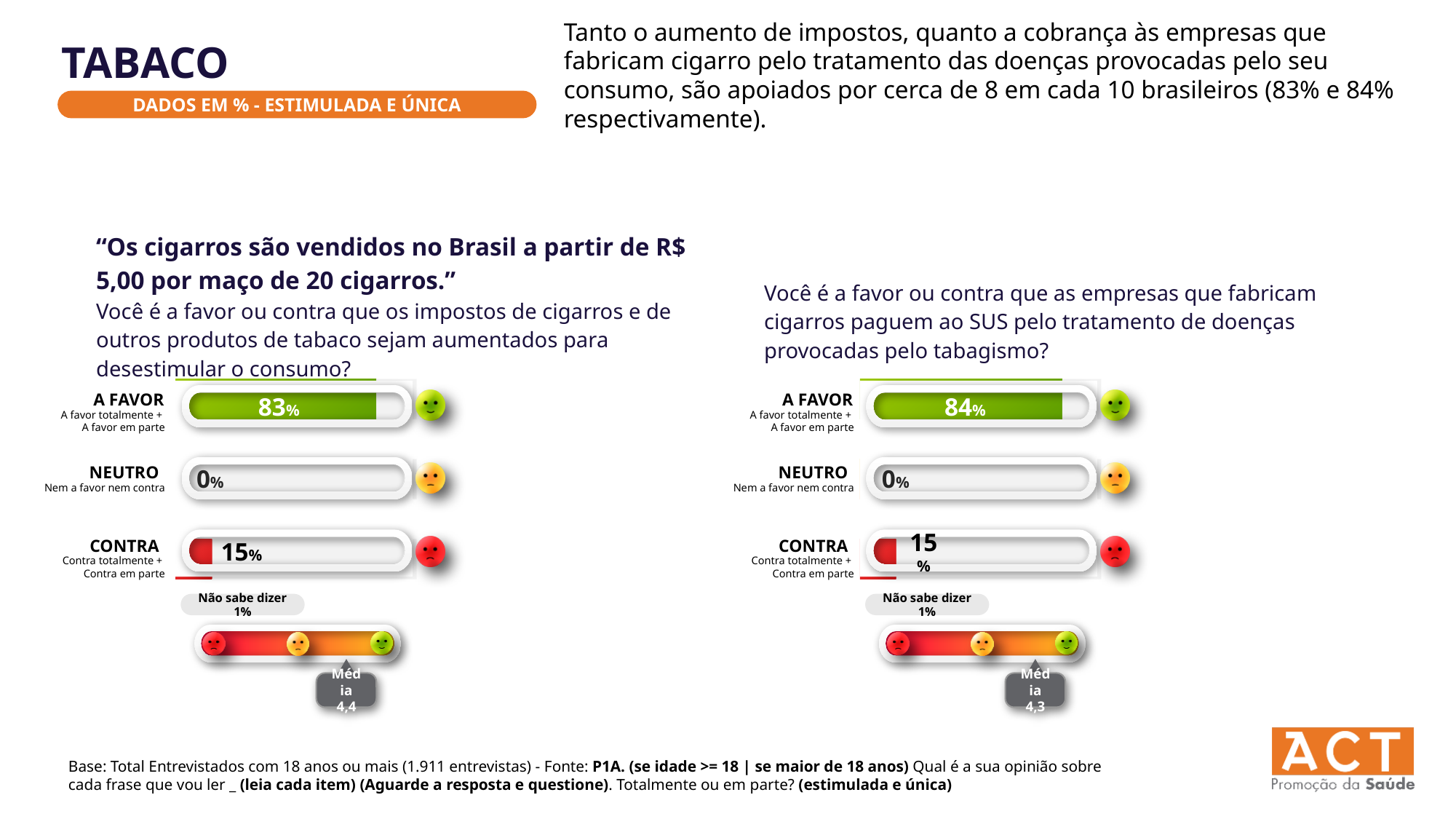
In the left chart about increasing cigarette taxes, which category has the highest value? A FAVOR In the right chart about companies paying the SUS, what percentage is shown for NEUTRO? 0% What percentage is shown for 'Não sabe dizer' in the right chart about companies paying the SUS? 1% In the left chart about increasing cigarette taxes, what is the difference between A FAVOR and CONTRA? 68 percentage points In the left chart about increasing cigarette taxes, what percentage is shown for CONTRA? 15% In the right chart about companies paying the SUS, what is the difference between A FAVOR and CONTRA? 69 percentage points In the right chart about companies paying the SUS, which category has the lowest value? NEUTRO In the left chart about increasing cigarette taxes, what percentage is shown for A FAVOR? 83% How many response categories are shown as bars in the left chart about increasing cigarette taxes? 3 What is the Média (average) value shown below the left chart about increasing cigarette taxes? 4,4 Which is larger: A FAVOR in the left chart (taxes) or A FAVOR in the right chart (SUS)? A FAVOR in the right chart (84%) In the right chart about companies paying the SUS, what percentage is shown for A FAVOR? 84%